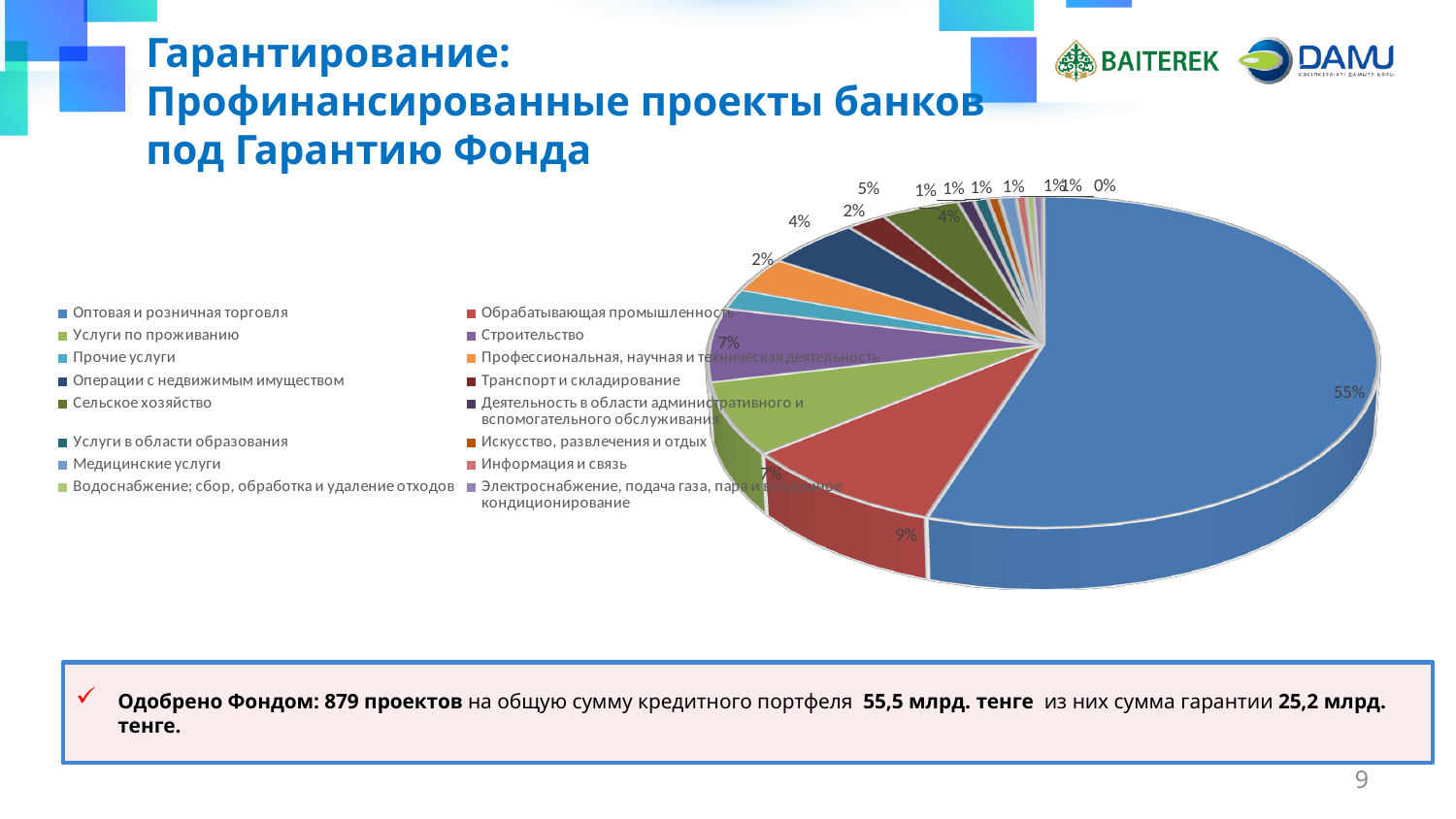
What is the value shown for Операции с недвижимым имуществом? 5% What is the value shown for Услуги по проживанию? 7% What is the value shown for Обрабатывающая промышленность? 9% Which is larger, the share for Оптовая и розничная торговля or for Обрабатывающая промышленность? Оптовая и розничная торговля What kind of chart is shown on the slide? Pie chart What share of the pie does Оптовая и розничная торговля have? 55% What is the difference in percentage points between Оптовая и розничная торговля (55%) and Обрабатывающая промышленность (9%)? 46 percentage points What colour is the slice for Оптовая и розничная торговля? Blue Is the share for Оптовая и розничная торговля greater or less than 50%? greater Which category has the largest share of the pie? Оптовая и розничная торговля What is the title of the slide containing the chart? Гарантирование: Профинансированные проекты банков под Гарантию Фонда How many categories does the legend list? 16